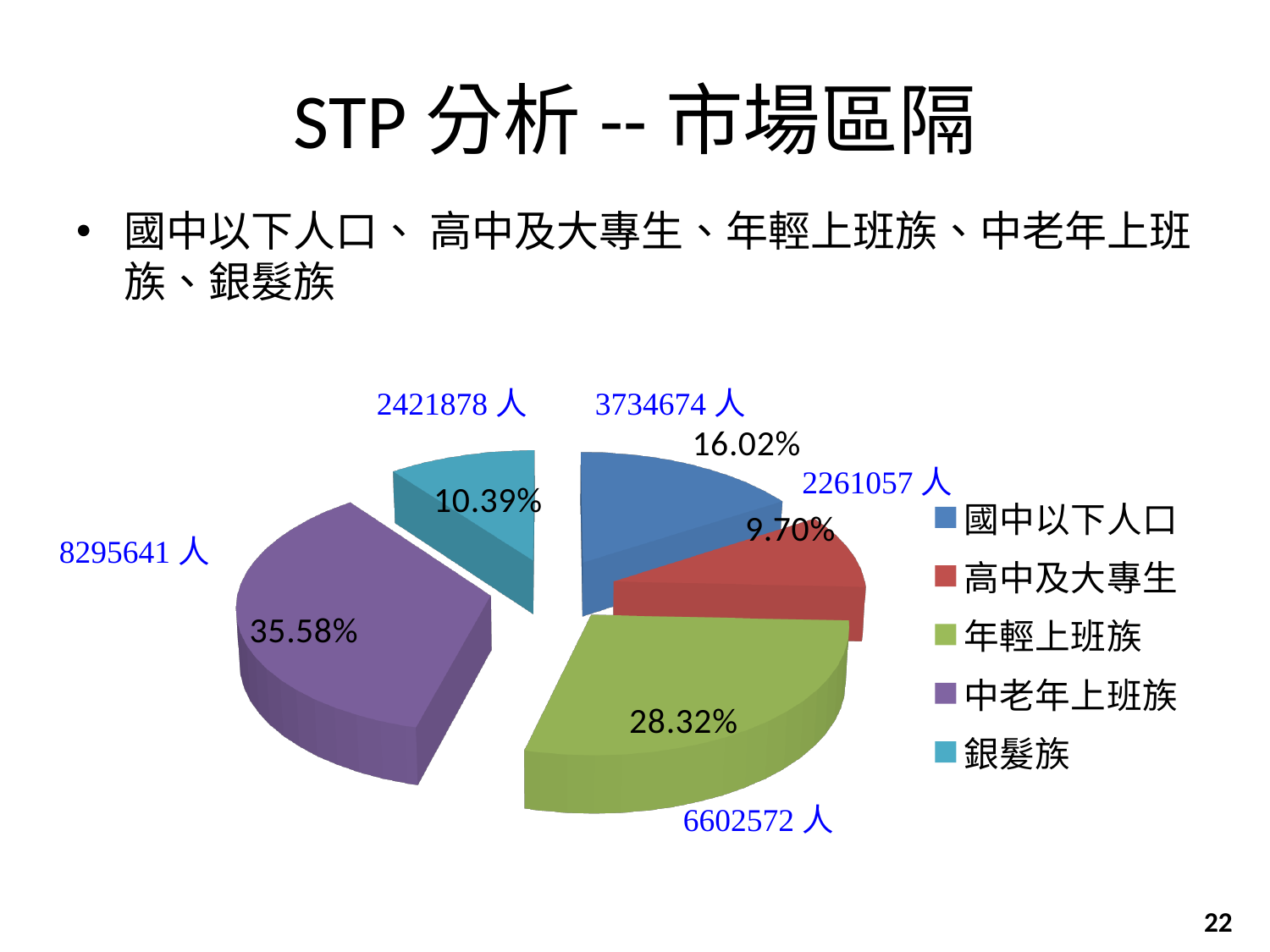
What percentage share does 高中及大專生 have in the pie chart? 9.70% Which has a larger share, 國中以下人口 or 銀髮族? 國中以下人口 What percentage share does 中老年上班族 have in the pie chart? 35.58% What kind of chart is shown on the slide? pie chart What is the difference in percentage share between 中老年上班族 and 年輕上班族? 7.26% What percentage share does 銀髮族 have in the pie chart? 10.39% What is the population figure shown for 國中以下人口? 3734674 人 Which segment has the smallest share of the pie chart? 高中及大專生 Which segment has the largest share of the pie chart? 中老年上班族 What colour is the 年輕上班族 slice in the pie chart? green How many slices does the pie chart have? 5 What is the population figure shown for 年輕上班族? 6602572 人